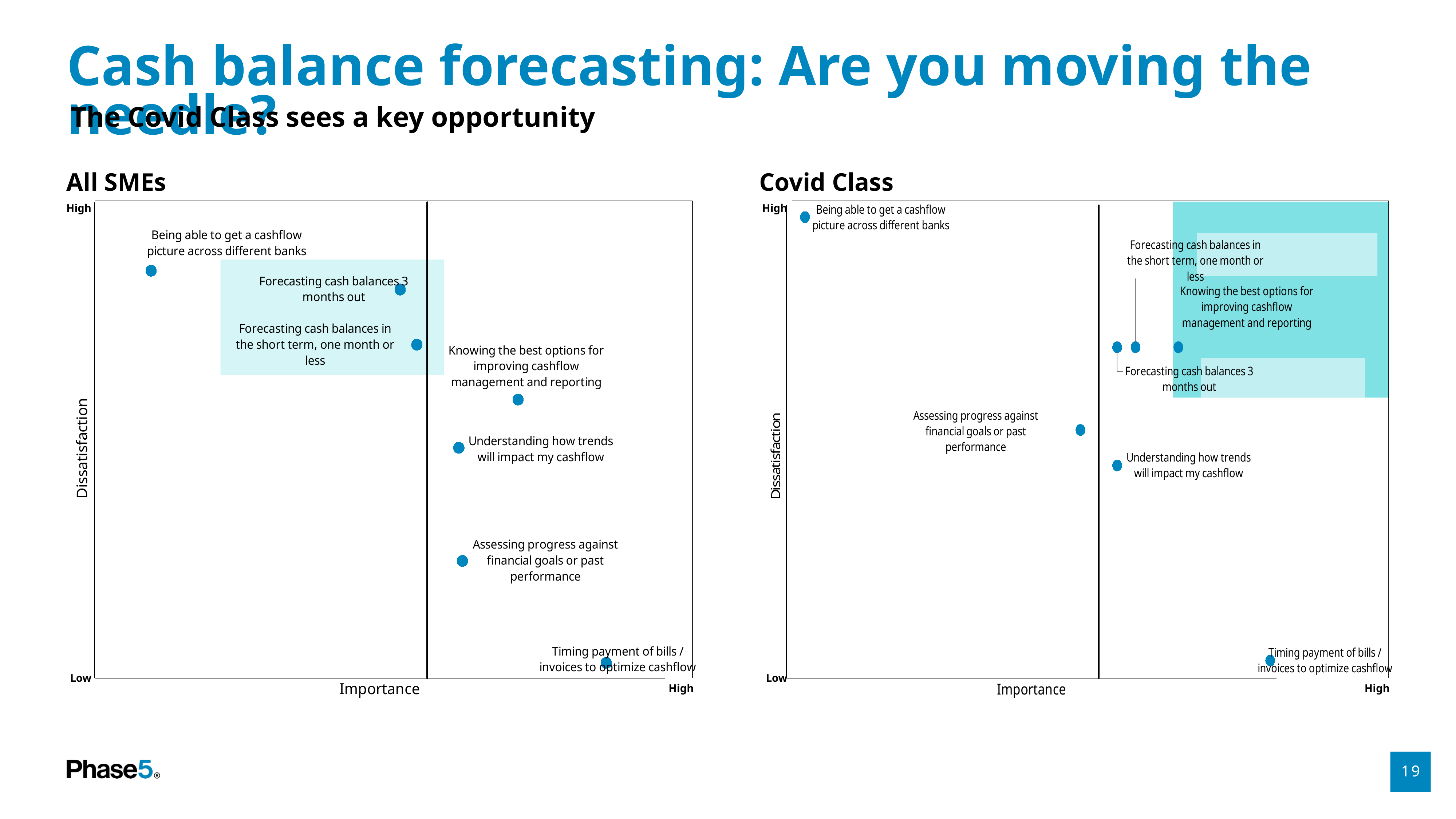
How many data points are plotted on the All SMEs chart? 7 What kind of chart is the All SMEs chart? Scatter chart On the Covid Class chart, which has higher importance: Understanding how trends will impact my cashflow or Assessing progress against financial goals or past performance? Understanding how trends will impact my cashflow On the All SMEs chart, which item has the highest dissatisfaction? Being able to get a cashflow picture across different banks What is the label of the horizontal axis on the Covid Class chart? Importance How many data points are plotted on the Covid Class chart? 7 On the All SMEs chart, which item has the lowest dissatisfaction? Timing payment of bills / invoices to optimize cashflow On the Covid Class chart, which item has the highest importance? Timing payment of bills / invoices to optimize cashflow On the Covid Class chart, which has higher dissatisfaction: Assessing progress against financial goals or past performance or Understanding how trends will impact my cashflow? Assessing progress against financial goals or past performance What is the label of the vertical axis on the All SMEs chart? Dissatisfaction On the Covid Class chart, which item has the lowest importance? Being able to get a cashflow picture across different banks On the All SMEs chart, which has higher dissatisfaction: Forecasting cash balances 3 months out or Assessing progress against financial goals or past performance? Forecasting cash balances 3 months out